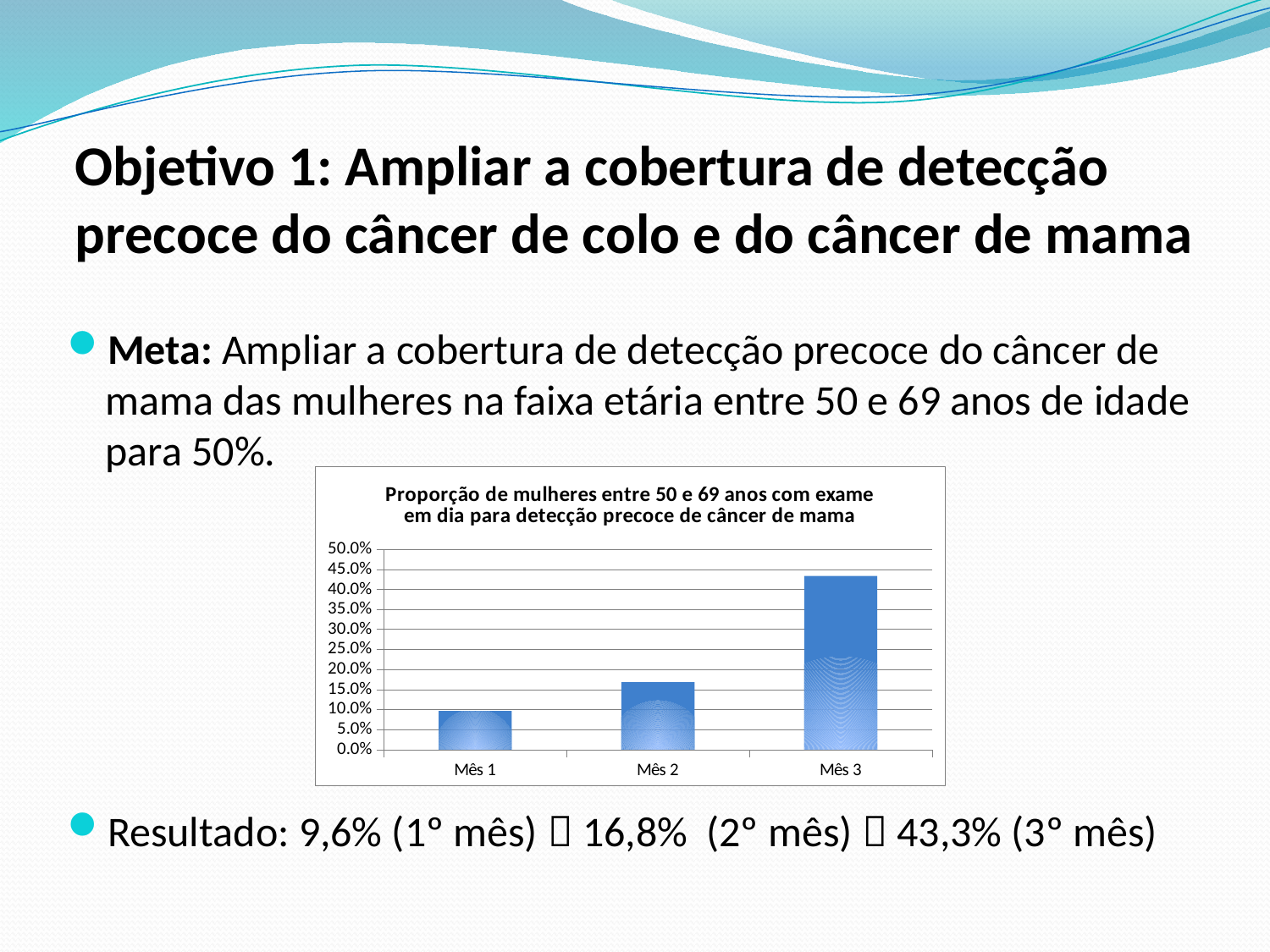
According to the slide, what was the result for the 1º mês? 9,6% Which month has the highest bar on the chart? Mês 3 Is the value for Mês 3 greater or less than 40.0%? greater Which month has the lowest bar on the chart? Mês 1 How many categories (months) are plotted on the chart? 3 Do the values rise or fall from Mês 1 to Mês 3? rise According to the slide, what was the result for the 3º mês? 43,3% Is the value for Mês 1 greater or less than 10.0%? less Which is larger, the value for Mês 2 or the value for Mês 3? Mês 3 What kind of chart is shown on the slide? bar chart What is the title of the chart? Proporção de mulheres entre 50 e 69 anos com exame em dia para detecção precoce de câncer de mama Is the value for Mês 2 greater or less than 15.0%? greater